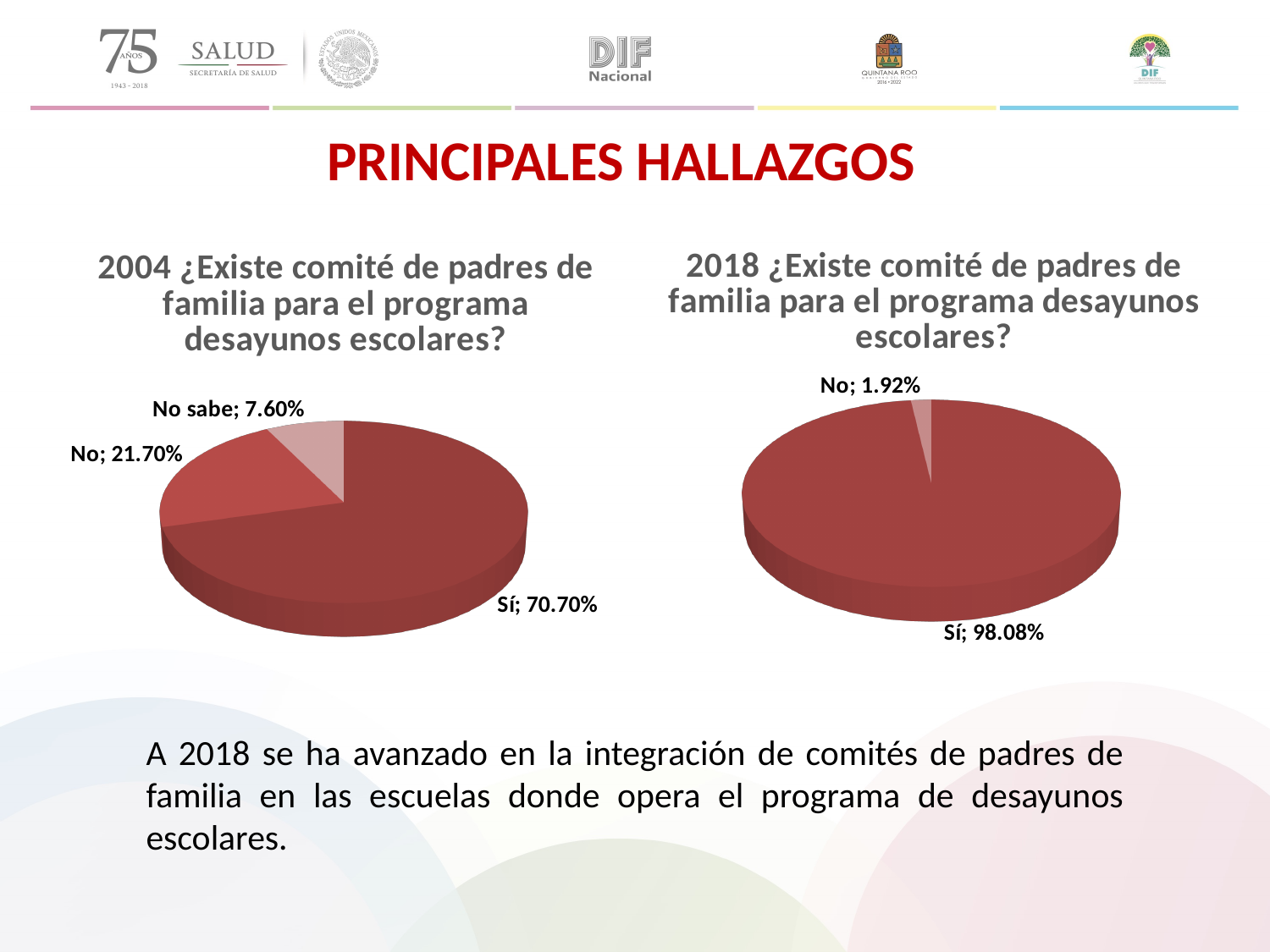
How many categories are shown in the 2004 pie chart? 3 What is the difference between the 'Sí' share in the 2018 chart and the 'Sí' share in the 2004 chart? 27.38% In the 2018 pie chart, which category has the smallest share? No In the 2004 pie chart, what percentage answered 'Sí'? 70.70% In the 2004 pie chart, which category has the smallest share? No sabe In the 2004 pie chart, what percentage answered 'No'? 21.70% What type of chart is used on the left side of the slide? Pie chart In the 2004 pie chart, what is the difference between the 'No' and 'No sabe' shares? 14.10% In the 2004 pie chart, which category has the largest share? Sí In the 2018 pie chart, what percentage answered 'No'? 1.92% In the 2004 pie chart, what percentage answered 'No sabe'? 7.60% In the 2018 pie chart, what percentage answered 'Sí'? 98.08%